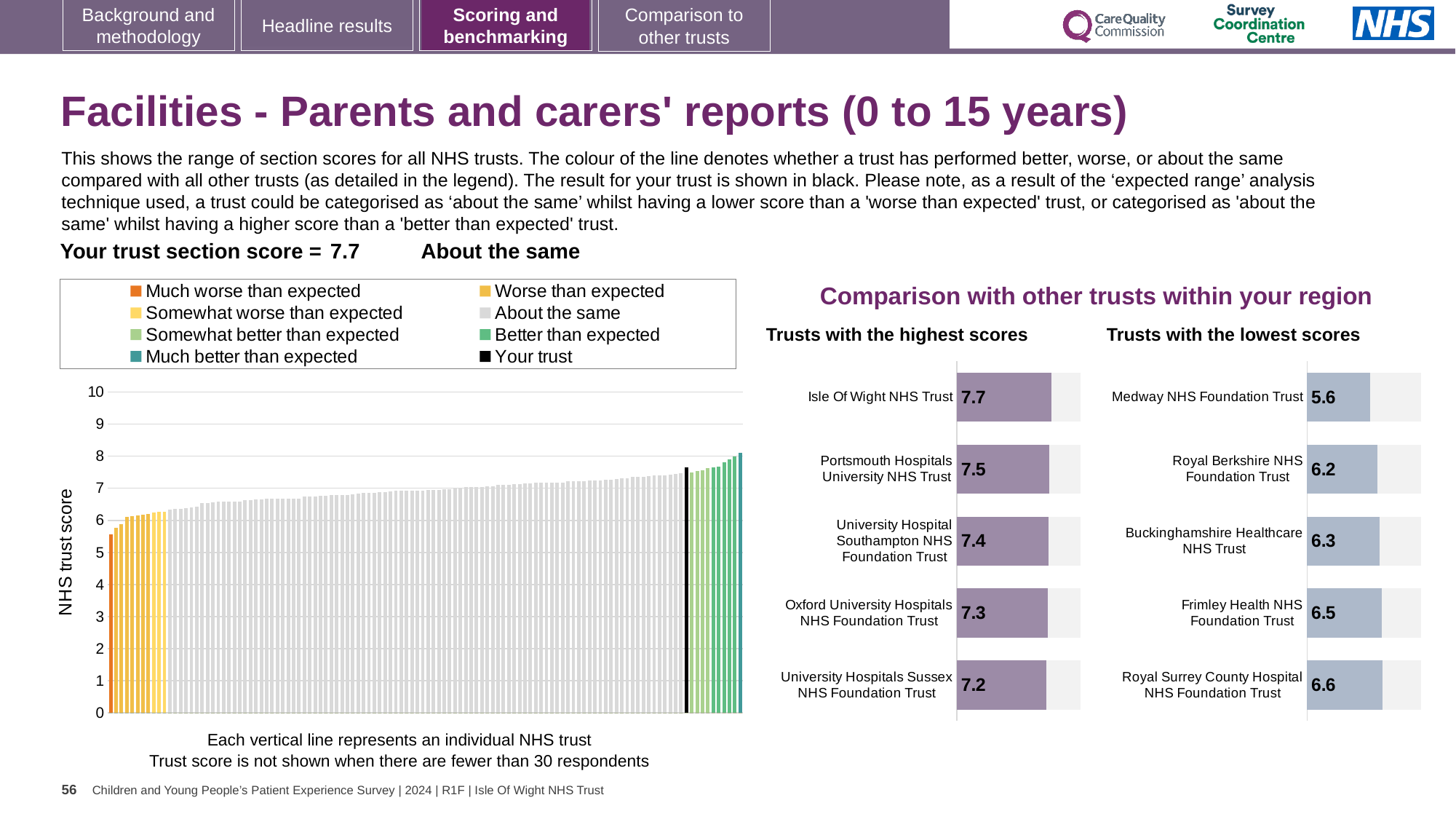
In the large 'NHS trust score' chart on the left, is the value of the lowest (leftmost) bar greater or less than 6? less How many trusts are shown in the 'Trusts with the highest scores' chart? 5 In the 'Trusts with the lowest scores' chart, what is the score for Medway NHS Foundation Trust? 5.6 In the 'Trusts with the highest scores' chart, which trust has the highest score? Isle Of Wight NHS Trust In the 'Trusts with the lowest scores' chart, what is the score for Frimley Health NHS Foundation Trust? 6.5 In the 'Trusts with the lowest scores' chart, which trust has the lowest score? Medway NHS Foundation Trust In the 'Trusts with the highest scores' chart, what is the score for Isle Of Wight NHS Trust? 7.7 In the 'Trusts with the highest scores' chart, what is the difference between the scores of Isle Of Wight NHS Trust and University Hospitals Sussex NHS Foundation Trust? 0.5 In the 'Trusts with the lowest scores' chart, which has the larger score: Buckinghamshire Healthcare NHS Trust or Frimley Health NHS Foundation Trust? Frimley Health NHS Foundation Trust In the 'Trusts with the highest scores' chart, what is the score for Oxford University Hospitals NHS Foundation Trust? 7.3 In the large 'NHS trust score' chart on the left, how many entries does the legend list? 8 In the 'Trusts with the lowest scores' chart, what is the difference between the scores of Royal Surrey County Hospital NHS Foundation Trust and Medway NHS Foundation Trust? 1.0